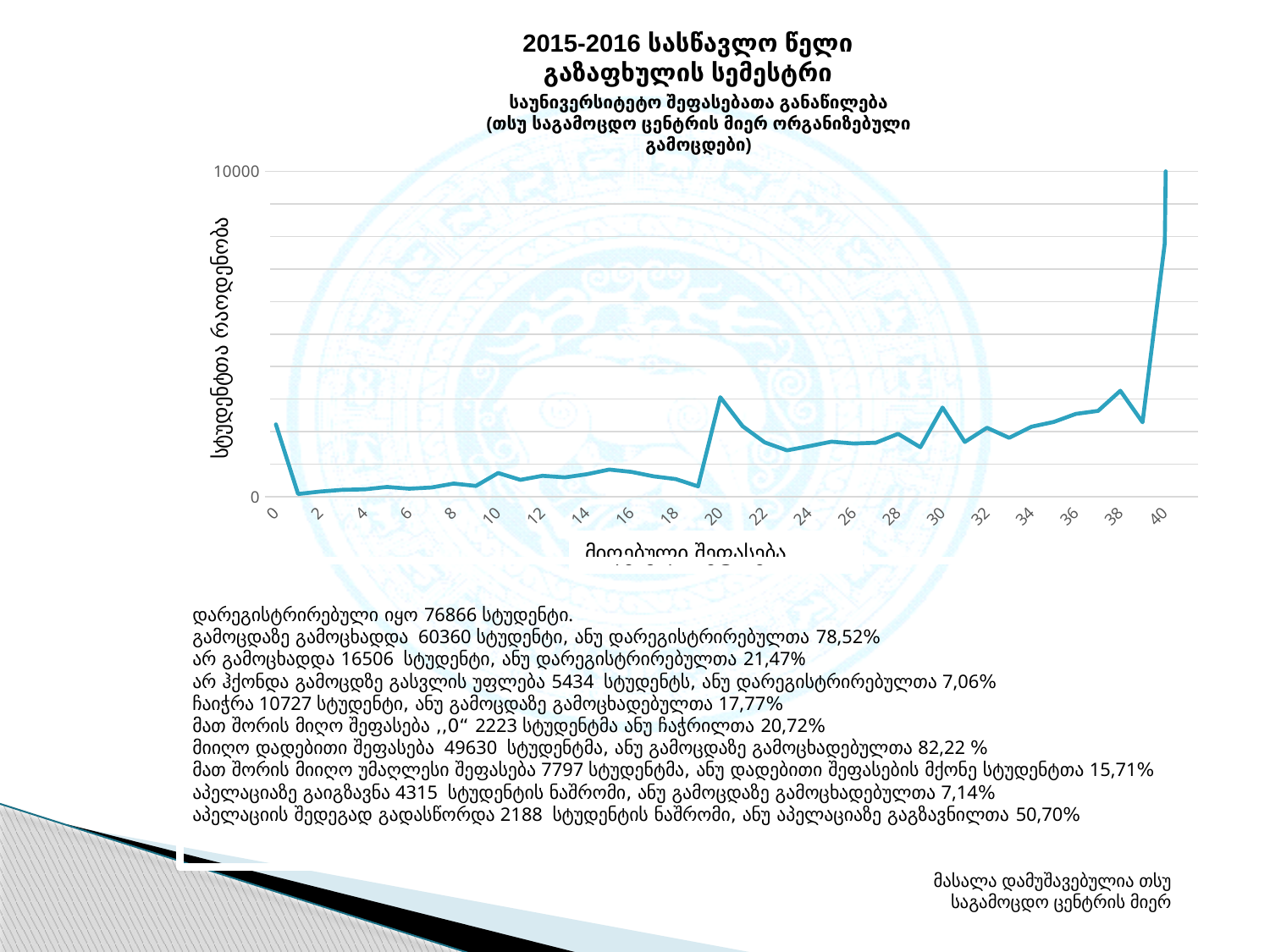
What kind of chart is shown on the slide? line chart Which has the larger value, x = 20 or x = 10? 20 Is the value at x = 1 greater or less than 1000? less Which has the larger value, x = 38 or x = 39? 38 What is the highest value labelled on the y axis? 10000 Is the value at x = 10 greater or less than 5000? less At which x-axis value does the line reach its highest point? 40 Which has the larger value, x = 0 or x = 1? 0 Is the value at x = 0 greater or less than 1000? greater What is the label of the y axis? სტუდენტთა რაოდენობა